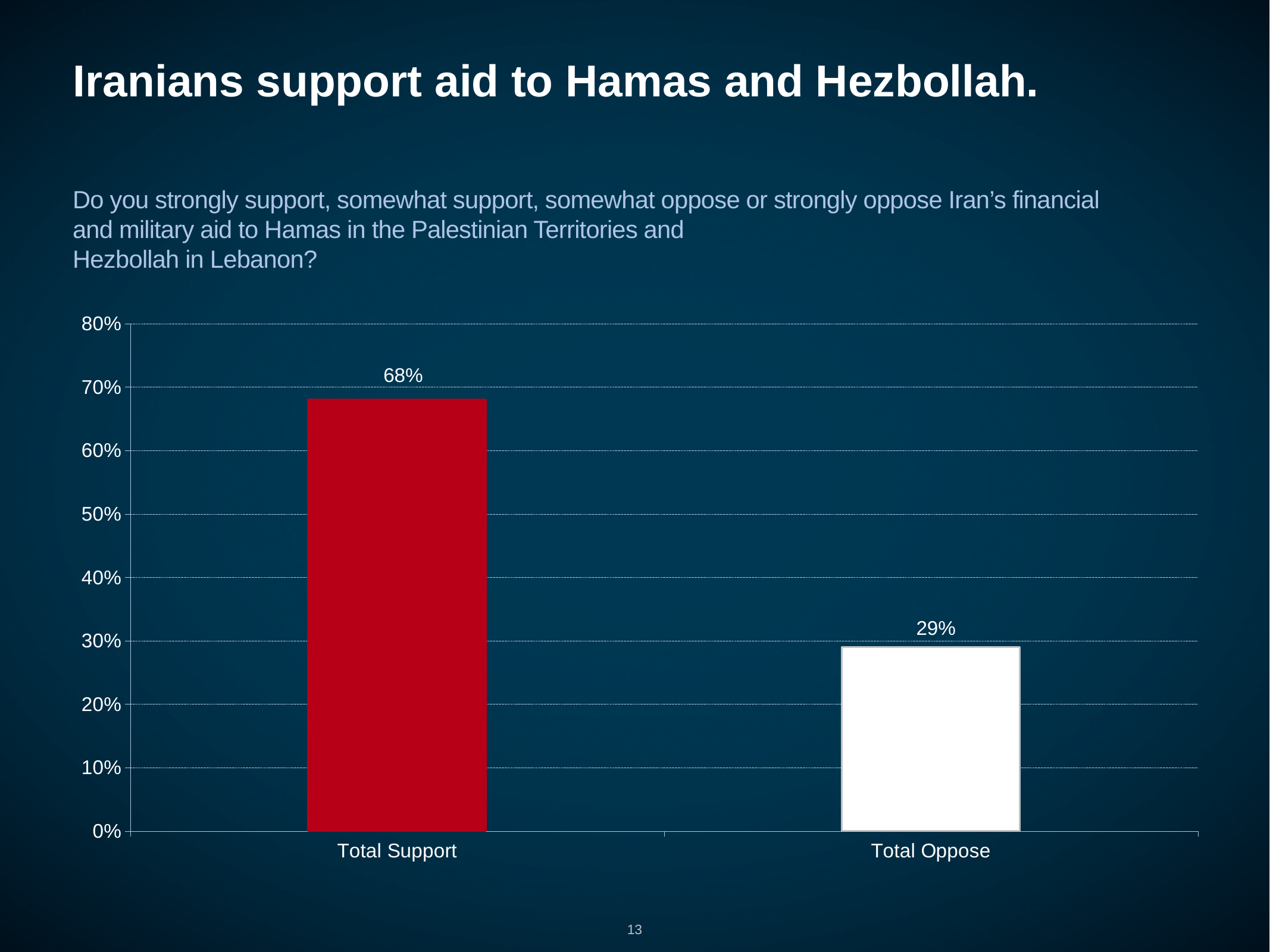
Which is larger, Total Support or Total Oppose? Total Support What is the value for Total Oppose? 29% What kind of chart is shown on the slide? bar chart How many categories are shown on the x axis? 2 What is the value for Total Support? 68% What colour is the Total Support bar? red Is the value for Total Oppose greater or less than 40%? less What is the highest value shown on the y axis? 80% Which category has the lowest value? Total Oppose What is the difference between Total Support and Total Oppose? 39% Is the value for Total Support greater or less than 60%? greater Which category has the highest value? Total Support